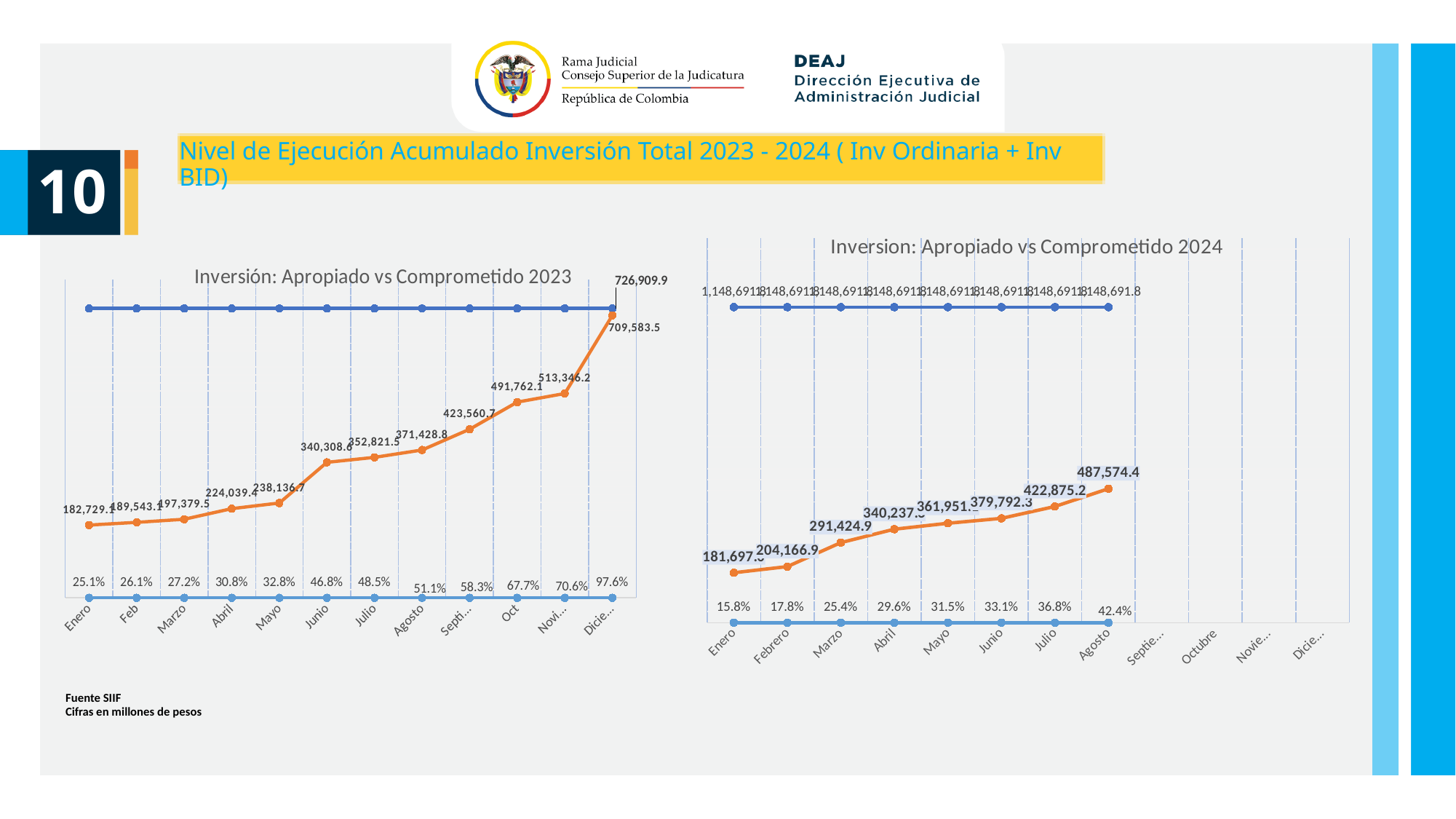
In the 'Inversion: Apropiado vs Comprometido 2024' chart, what is the difference between the orange line values for Agosto and Julio? 64,699.2 In the 'Inversion: Apropiado vs Comprometido 2024' chart, what percentage is shown for Julio? 36.8% What type of chart is 'Inversión: Apropiado vs Comprometido 2023'? line chart In the 'Inversion: Apropiado vs Comprometido 2024' chart, what is the value of the orange line for Agosto? 487,574.4 In the 'Inversión: Apropiado vs Comprometido 2023' chart, what is the difference between the orange line values for Dicie... and Novi...? 196,237.3 In the 'Inversion: Apropiado vs Comprometido 2024' chart, what is the value of the blue line for Marzo? 1,148,691.8 In the 'Inversión: Apropiado vs Comprometido 2023' chart, what is the value of the orange line for Dicie...? 709,583.5 In the 'Inversión: Apropiado vs Comprometido 2023' chart, does the orange line rise or fall from Enero to Dicie...? rise In the 'Inversión: Apropiado vs Comprometido 2023' chart, which month has the lowest orange line value? Enero In the 'Inversion: Apropiado vs Comprometido 2024' chart, how many months have plotted orange line values? 8 In the 'Inversión: Apropiado vs Comprometido 2023' chart, what percentage is shown for Oct? 67.7% In the 'Inversión: Apropiado vs Comprometido 2023' chart, what is the value of the orange line for Junio? 340,308.6